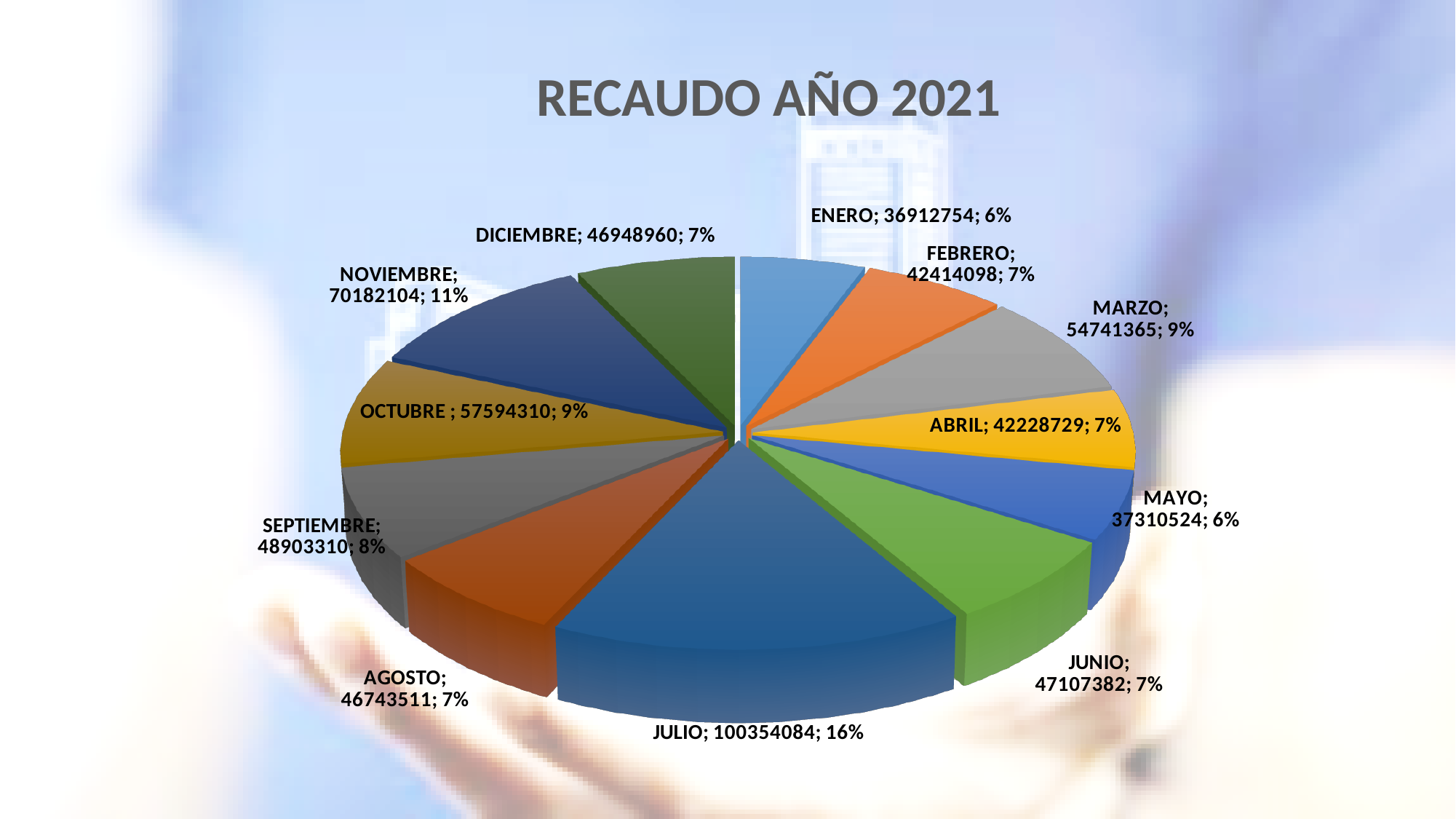
What is the title of the chart? RECAUDO AÑO 2021 What type of chart is shown on the slide? Pie chart How many slices (months) does the pie chart have? 12 What percentage share does JULIO represent? 16% Which month has the highest value? JULIO What percentage share does MARZO represent? 9% What is the value for SEPTIEMBRE? 48903310 What is the value for JULIO? 100354084 What is the difference between the values for JULIO and NOVIEMBRE? 30171980 What is the value for NOVIEMBRE? 70182104 Which month has the lowest value? ENERO Which is larger, the value for OCTUBRE or the value for MARZO? OCTUBRE